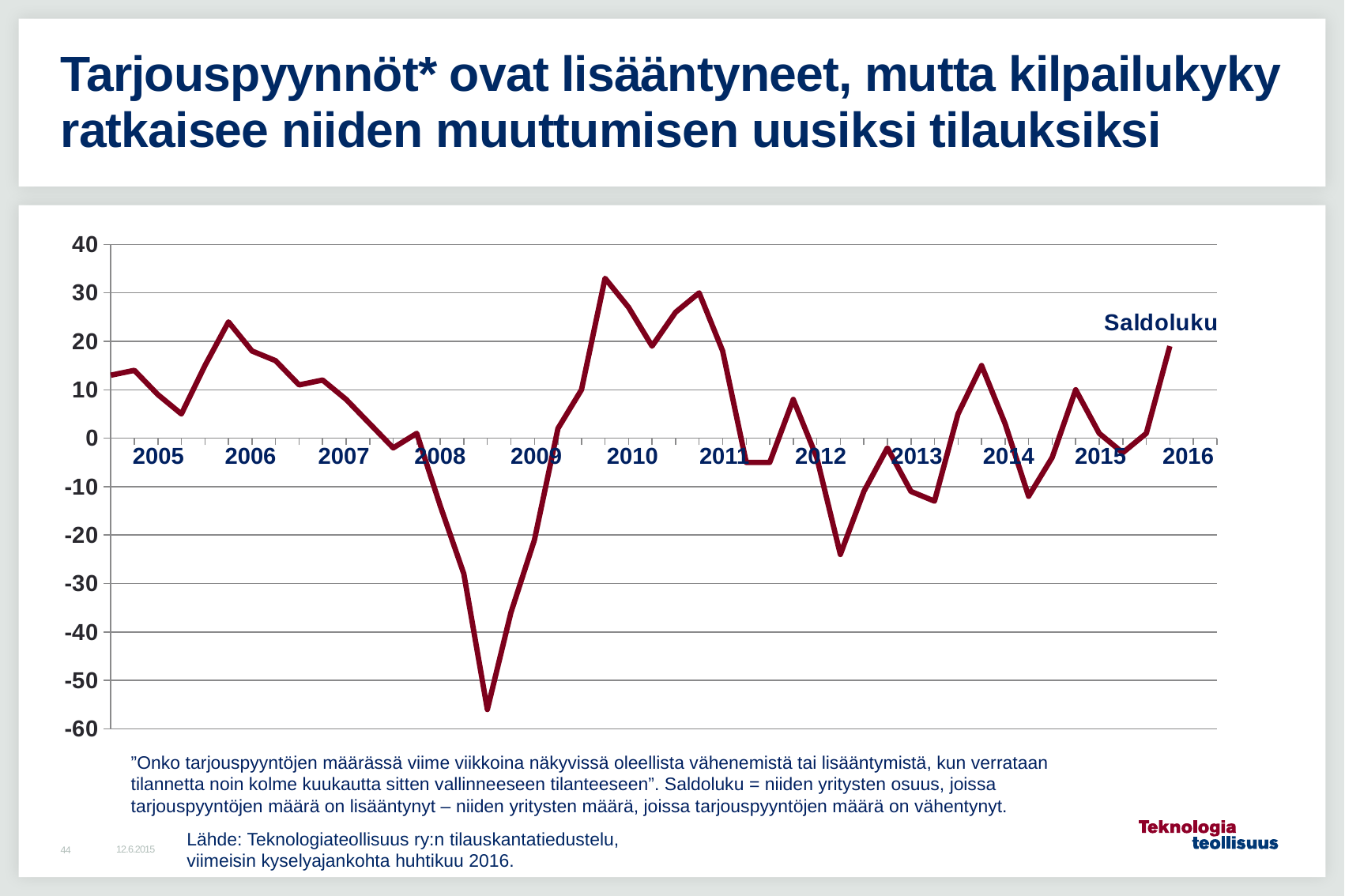
How many year labels are shown on the x axis? 12 Is the highest value of the line greater or less than 30? greater What kind of chart is shown on the slide? line chart Does the line rise or fall between 2015 and 2016? rise Is the value at the start of the line in 2005 greater or less than 10? greater What are the minimum and maximum values shown on the y axis? -60 and 40 What is the name of the series plotted on the chart? Saldoluku Is the lowest value of the line greater or less than -50? less How many series does the chart plot? 1 Which peak is higher: the one around 2006 or the one around 2010? the one around 2010